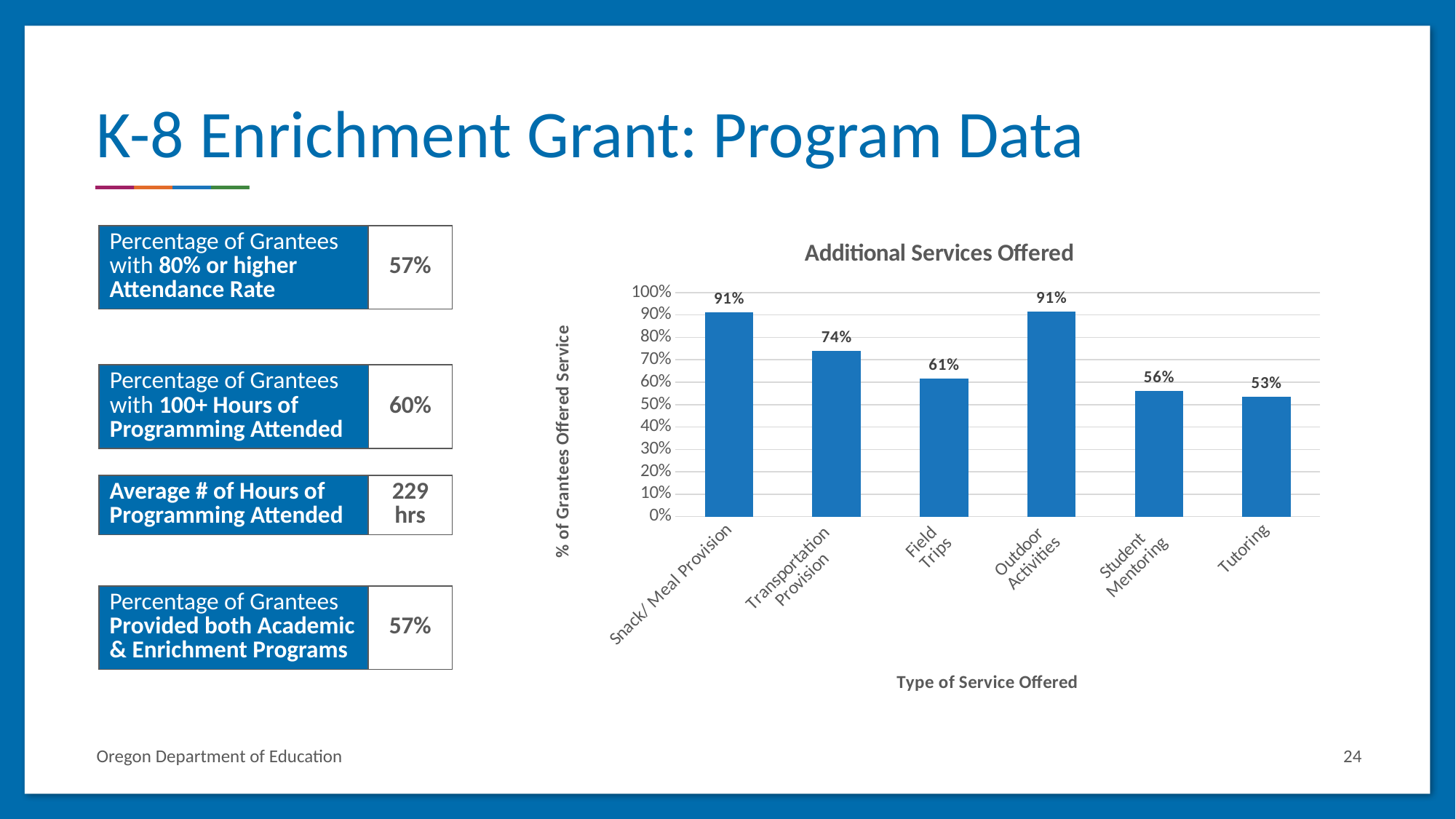
What percentage of grantees offered Outdoor Activities? 91% What percentage of grantees offered Field Trips? 61% How many types of service are shown in the chart? 6 What is the difference between the percentage for Snack/Meal Provision and the percentage for Tutoring? 38% What percentage of grantees offered Transportation Provision? 74% Which type of service has the lowest percentage of grantees offering it? Tutoring What type of chart is shown on the slide? bar chart What percentage of grantees offered Student Mentoring? 56% Which has a higher percentage, Transportation Provision or Field Trips? Transportation Provision What is the label of the x axis of the chart? Type of Service Offered What is the highest value shown in the chart? 91% What is the title of the chart? Additional Services Offered